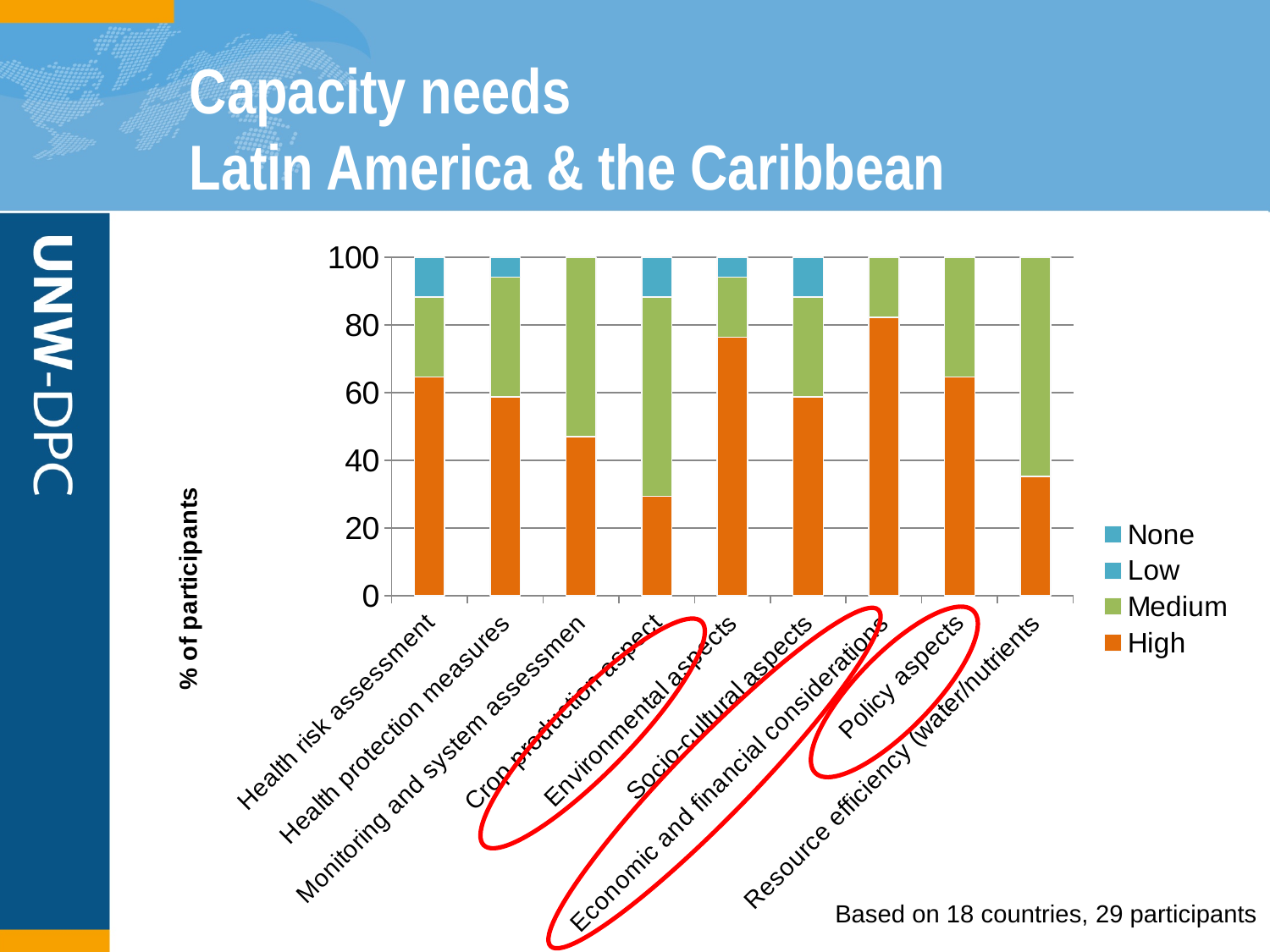
Which has a larger High segment, Environmental aspects or Health risk assessment? Environmental aspects Is the High value for Monitoring and system assessment greater or less than 60? less Is the High value for Crop production aspect greater or less than 40? less Is the High value for Environmental aspects greater or less than 60? greater How many categories are shown on the x axis of the chart? 9 How many series does the chart's legend list? 4 Which category has the largest High segment? Economic and financial considerations What is the label on the y axis of the chart? % of participants What is the total height of the stacked bar for Policy aspects? 100 Which category has the smallest High segment? Crop production aspect What kind of chart is shown on the slide? Stacked bar chart